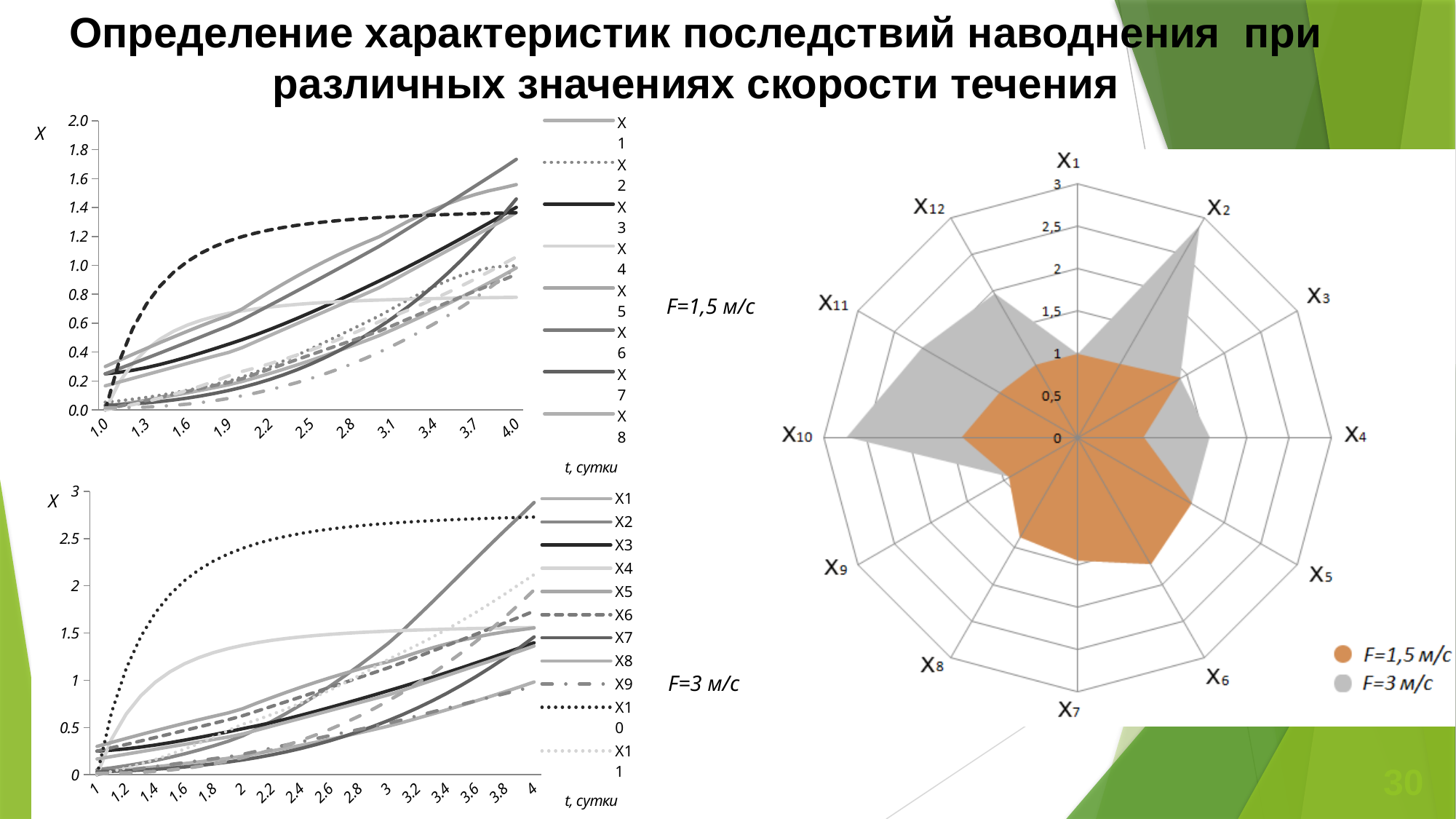
In the radar chart on the right, is the F=1,5 м/с value for X1 greater or less than 1.5? less What kind of chart is the top-left chart labelled F=1,5 м/с? line chart In the radar chart on the right, which series is shown in grey? F=3 м/с What kind of chart is the chart on the right side of the slide? radar chart How many categories (axes) does the radar chart on the right have? 12 In the bottom-left chart labelled F=3 м/с, is the value of X10 at t=4 greater or less than 2.5? greater In the radar chart on the right, which series has the larger value for X10, F=1,5 м/с or F=3 м/с? F=3 м/с In the bottom-left chart labelled F=3 м/с, does the X10 series rise or fall as t increases? rise How many series does the legend of the bottom-left chart labelled F=3 м/с list? 11 In the radar chart on the right, which series is shown in orange? F=1,5 м/с In the radar chart on the right, is the F=3 м/с value for X2 greater or less than 2.5? greater How many series does the legend of the radar chart on the right list? 2